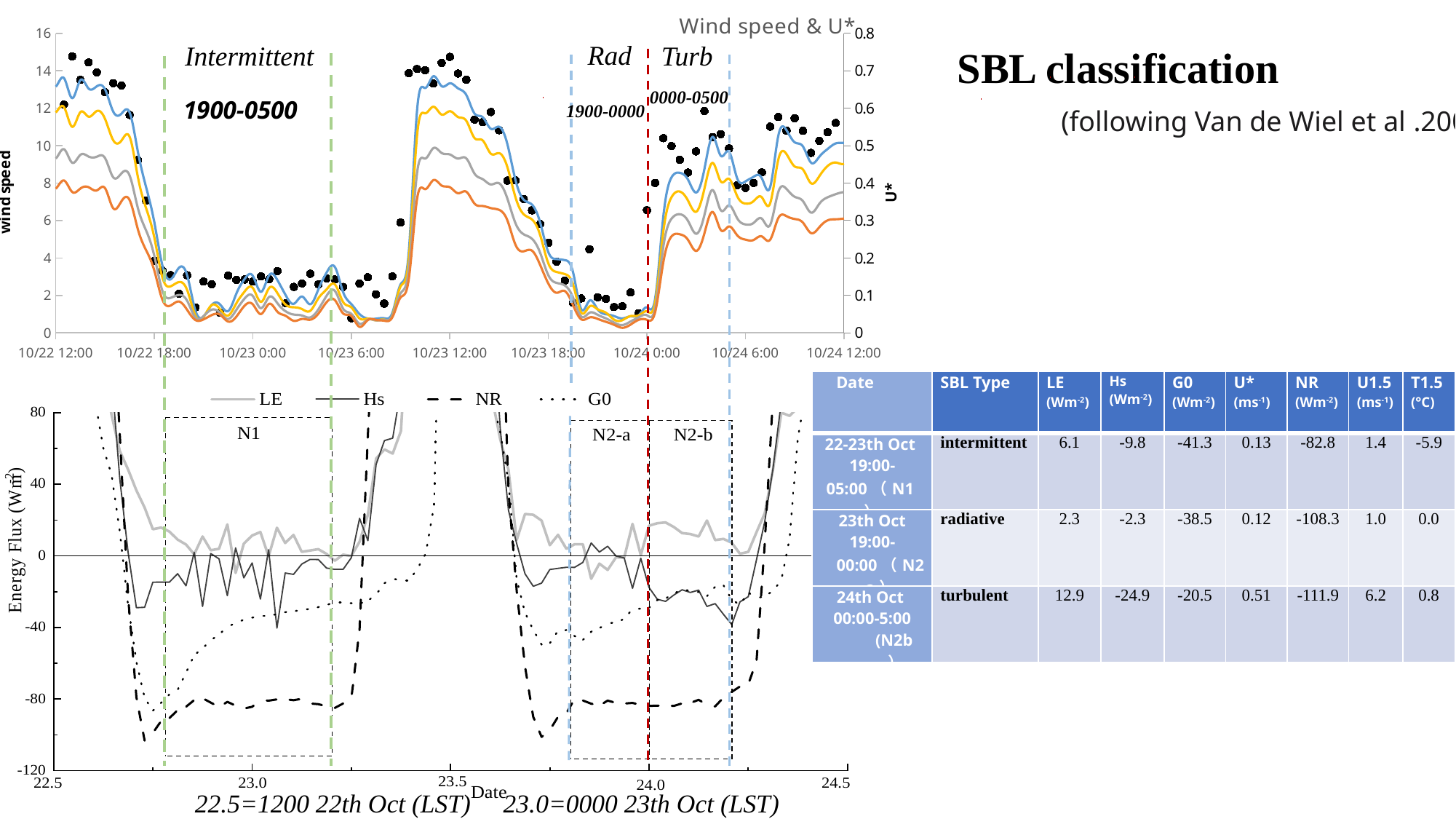
How many series does the legend of the bottom Energy Flux chart list? 4 In the top Wind speed & U* chart, do the wind speed lines rise or fall between 10/23 12:00 and 10/23 18:00? fall What are the legend entries of the bottom Energy Flux chart? LE, Hs, NR, G0 What kind of chart is the bottom chart labelled Energy Flux? line chart In the bottom Energy Flux chart, does the NR line rise or fall between 23.2 and 23.3? rise In the top Wind speed & U* chart, do the wind speed lines rise or fall between 10/23 6:00 and 10/23 12:00? rise In the top Wind speed & U* chart, is the highest wind speed line at 10/23 12:00 greater or less than 10? greater In the bottom Energy Flux chart, is the Hs value at 23.0 greater or less than 0? less In the bottom Energy Flux chart, is the NR value at 23.0 greater or less than -40? less What is the title of the top chart? Wind speed & U*